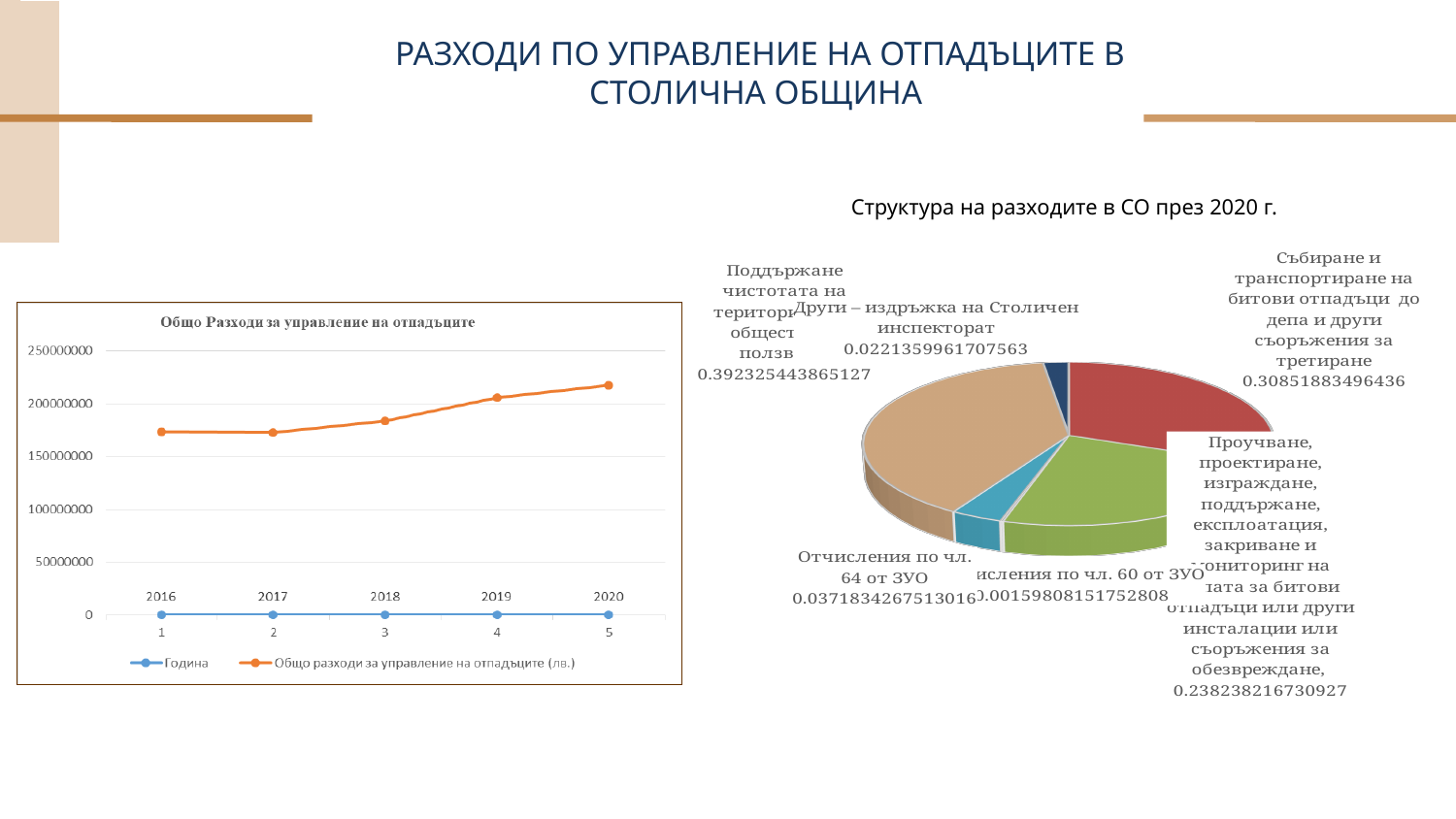
In the pie chart "Структура на разходите в СО през 2020 г.", what is the value shown for "Поддържане чистотата на територии за обществено ползване"? 0.392325443865127 In the line chart "Общо Разходи за управление на отпадъците", do the values of "Общо разходи за управление на отпадъците (лв.)" generally rise or fall from 2016 to 2020? rise In the line chart "Общо Разходи за управление на отпадъците", is the value of "Общо разходи за управление на отпадъците (лв.)" for 2020 greater or less than 200000000? greater In the line chart "Общо Разходи за управление на отпадъците", how many series does the legend list? 2 In the pie chart "Структура на разходите в СО през 2020 г.", what is the value shown for "Отчисления по чл. 64 от ЗУО"? 0.0371834267513016 In the pie chart "Структура на разходите в СО през 2020 г.", what is the value shown for "Други – издръжка на Столичен инспекторат"? 0.0221359961707563 In the line chart "Общо Разходи за управление на отпадъците", is the value of "Общо разходи за управление на отпадъците (лв.)" for 2016 greater or less than 200000000? less In the line chart "Общо Разходи за управление на отпадъците", which year has the highest value of "Общо разходи за управление на отпадъците (лв.)"? 2020 In the line chart "Общо Разходи за управление на отпадъците", how many years are plotted along the x axis? 5 What type of chart is the chart titled "Структура на разходите в СО през 2020 г." on the right of the slide? pie chart What type of chart is the chart titled "Общо Разходи за управление на отпадъците" on the left of the slide? line chart In the pie chart "Структура на разходите в СО през 2020 г.", which is larger: the value for "Събиране и транспортиране на битови отпадъци до депа и други съоръжения за третиране" or the value for "Отчисления по чл. 64 от ЗУО"? Събиране и транспортиране на битови отпадъци до депа и други съоръжения за третиране